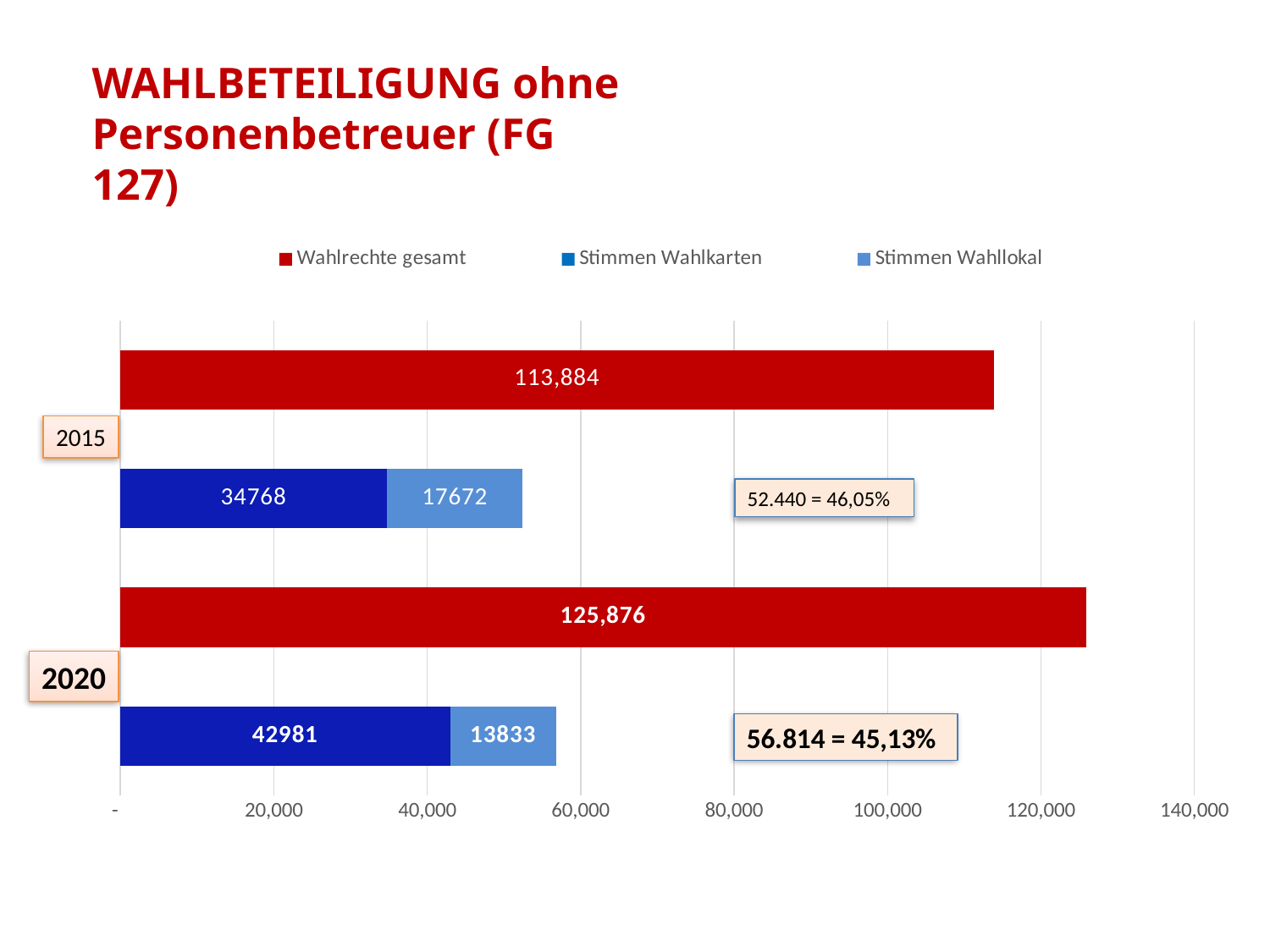
What is the value of Stimmen Wahlkarten for 2020? 42981 What is the value of Wahlrechte gesamt for 2020? 125,876 What is the value of Stimmen Wahllokal for 2015? 17672 What is the difference between Wahlrechte gesamt in 2020 and in 2015? 11,992 Which year has the lower value for Stimmen Wahllokal? 2020 How many series does the legend list? 3 What kind of chart is shown on the slide? Bar chart What is the value of Wahlrechte gesamt for 2015? 113,884 Which year has the higher value for Wahlrechte gesamt? 2020 Is Stimmen Wahlkarten larger in 2015 or in 2020? 2020 What is the total of the stacked bar for Stimmen Wahlkarten and Stimmen Wahllokal in 2020? 56814 What percentage is shown in the text box next to the 2015 stacked bar? 46,05%